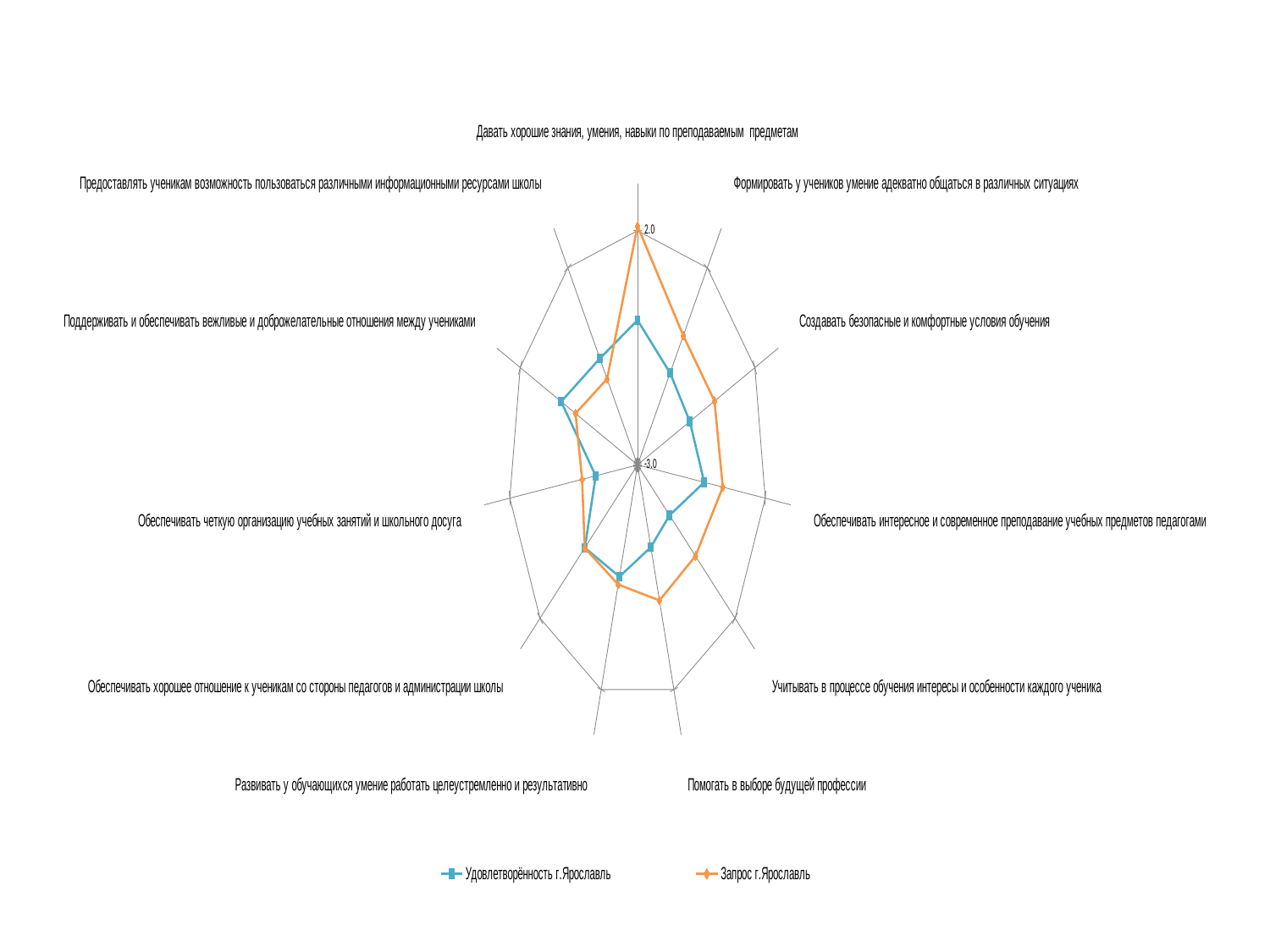
What value is labeled at the centre of the radar chart's axis? -3,0 For the category 'Формировать у учеников умение адекватно общаться в различных ситуациях', which series has the larger value? Запрос г.Ярославль What kind of chart is shown on the slide? Radar chart In which category does the series 'Запрос г.Ярославль' reach its highest value? Давать хорошие знания, умения, навыки по преподаваемым предметам How many categories (axes) does the radar chart have? 11 For the category 'Давать хорошие знания, умения, навыки по преподаваемым предметам', which series has the larger value? Запрос г.Ярославль How many series does the legend list? 2 For the category 'Создавать безопасные и комфортные условия обучения', which series has the larger value? Запрос г.Ярославль What are the two series named in the legend? Удовлетворённость г.Ярославль and Запрос г.Ярославль